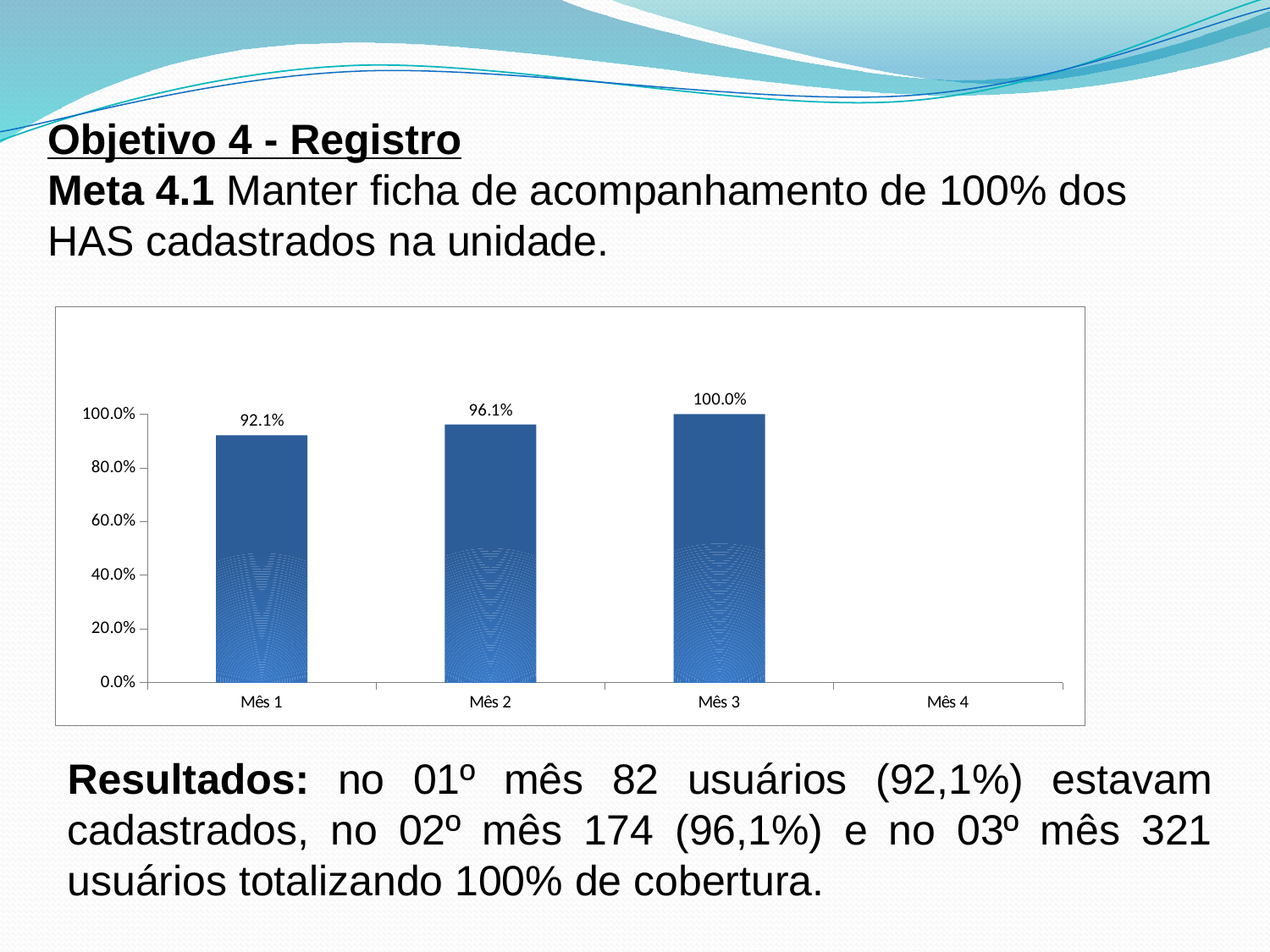
What is the value for Mês 3? 100.0% What kind of chart is shown on the slide? bar chart Which is larger, the value for Mês 2 or the value for Mês 1? Mês 2 Among the months with a plotted bar, which has the lowest value? Mês 1 What is the difference between the values for Mês 3 and Mês 1? 7.9% What is the value for Mês 1? 92.1% What is the value for Mês 2? 96.1% How many categories are shown on the x axis? 4 Do the values rise or fall from Mês 1 to Mês 3? rise What is the difference between the values for Mês 2 and Mês 1? 4.0% Is the value for Mês 1 greater or less than 80.0%? greater Which month has the highest value? Mês 3